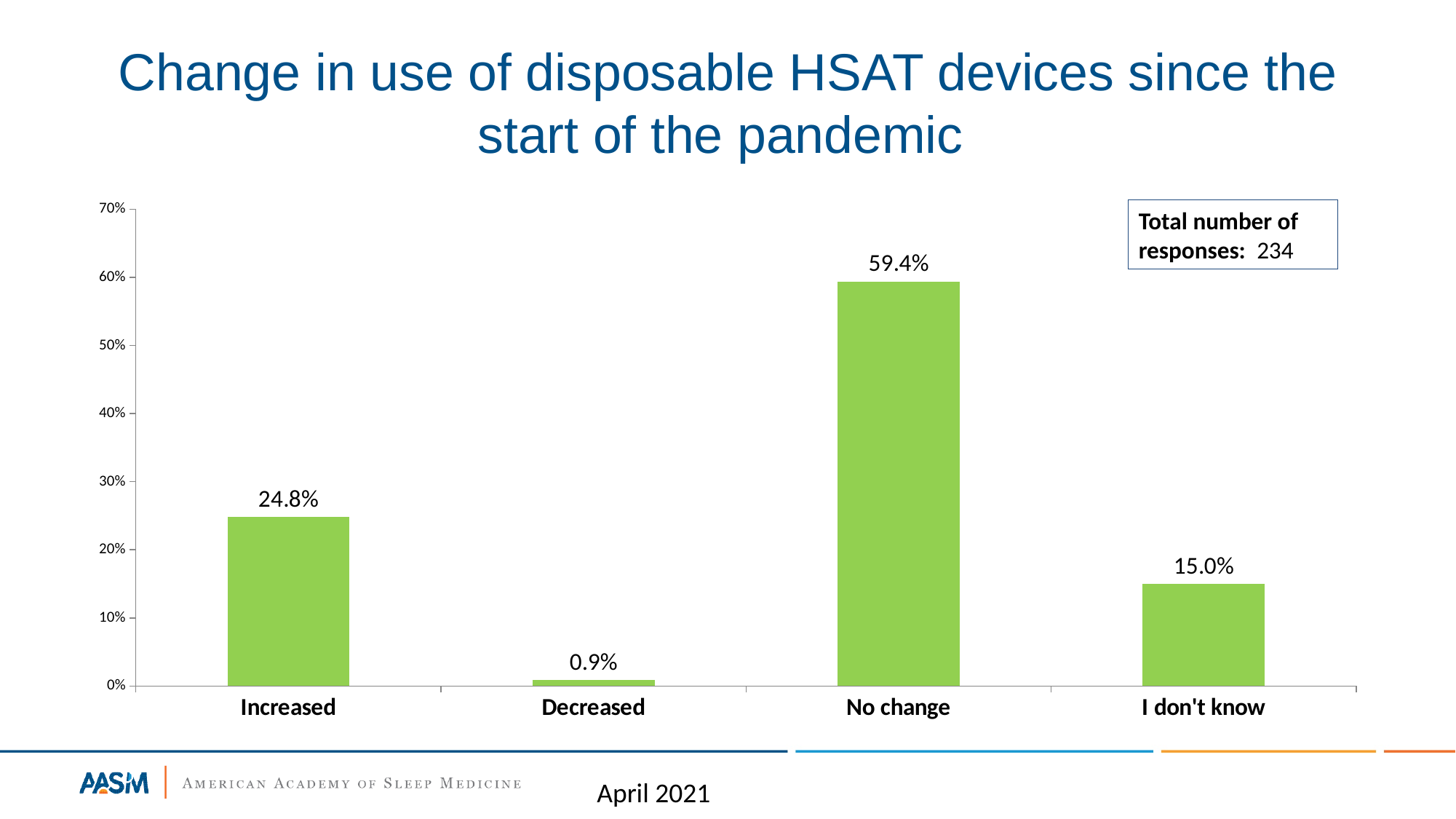
Which category has the lowest value? Decreased How many categories are shown on the x axis? 4 What is the value for the 'I don't know' category? 15.0% What kind of chart is shown on the slide? Bar chart What percentage of respondents reported that their use of disposable HSAT devices increased? 24.8% Which category has the highest value? No change What is the value shown for the 'Decreased' category? 0.9% What is the total number of responses stated on the slide? 234 What percentage of respondents reported 'No change'? 59.4% What is the difference in percentage points between 'No change' and 'Increased'? 34.6 Is the value for 'No change' greater or less than 50%? greater Which is larger, the value for 'Increased' or the value for 'I don't know'? Increased